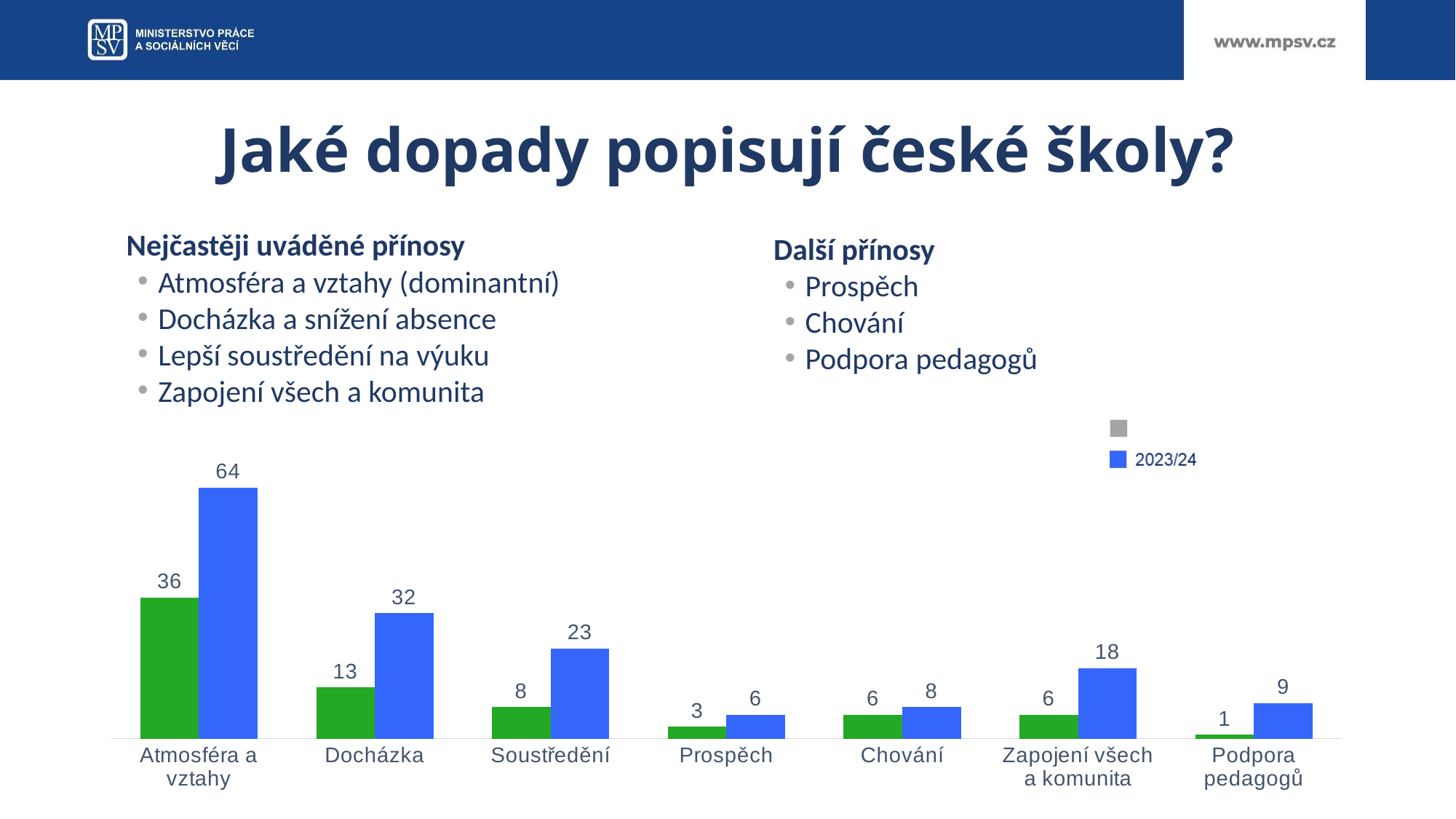
What is the 2023/24 value for Docházka? 32 What is the difference between the 2023/24 value and the green bar value for Atmosféra a vztahy? 28 What value does the green bar show for Soustředění? 8 How many categories are shown on the x axis? 7 What is the 2023/24 value for Atmosféra a vztahy? 64 What kind of chart is shown on the slide? bar chart Which category has the highest 2023/24 value? Atmosféra a vztahy Which is larger: the 2023/24 value for Zapojení všech a komunita or for Chování? Zapojení všech a komunita Which series label is shown in the legend next to the blue marker? 2023/24 What is the 2023/24 value for Podpora pedagogů? 9 Which category has the lowest green bar value? Podpora pedagogů What is the difference between the 2023/24 values for Docházka and Soustředění? 9